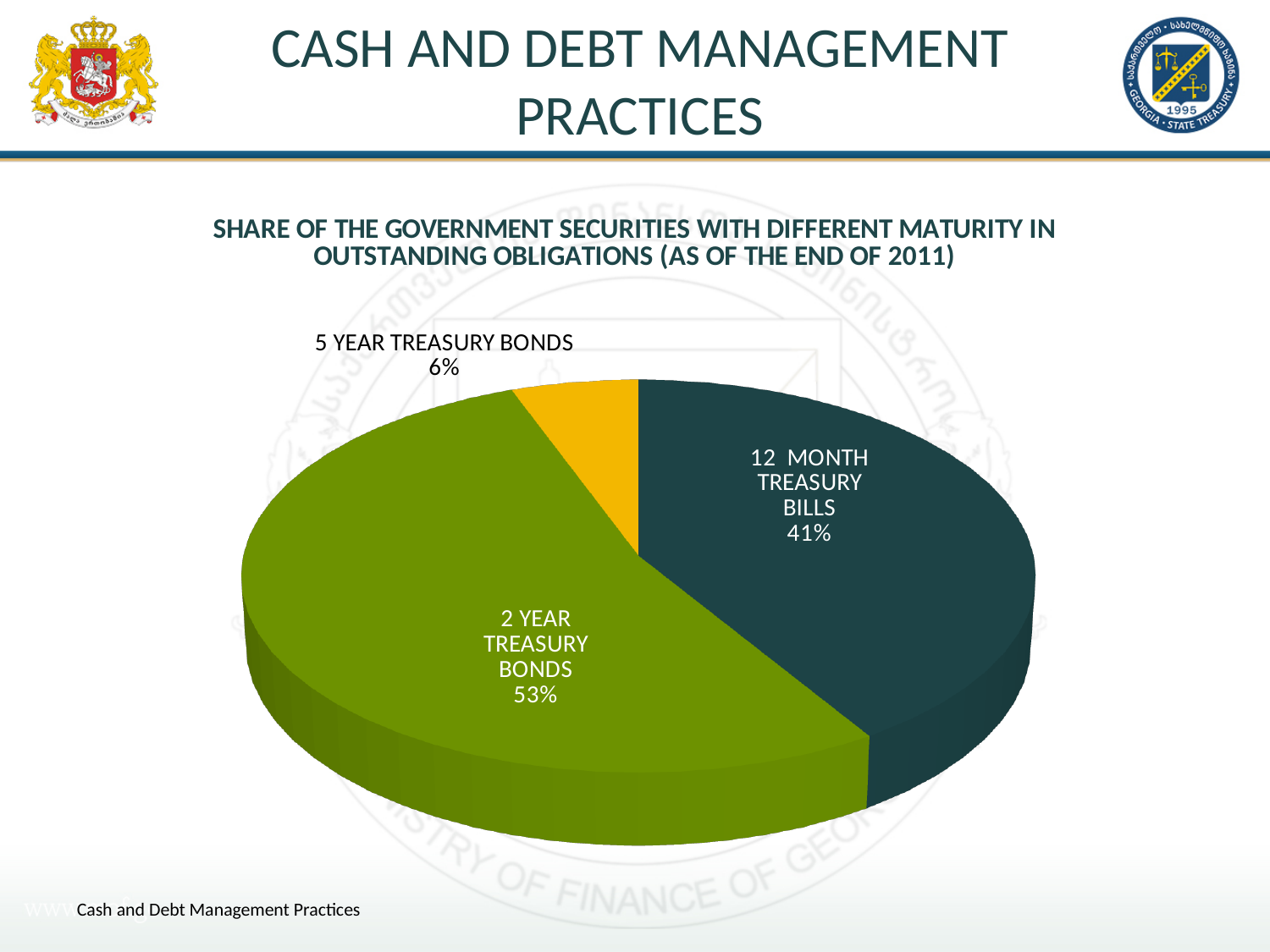
What kind of chart is shown on the slide? Pie chart Which has a larger share: 12 month treasury bills or 5 year treasury bonds? 12 month treasury bills What is the difference in share between 12 month treasury bills and 5 year treasury bonds? 35% What is the title of the chart? Share of the government securities with different maturity in outstanding obligations (as of the end of 2011) What share of outstanding obligations is held by 5 year treasury bonds? 6% Which security type has the smallest share of outstanding obligations? 5 year treasury bonds Which security type has the largest share of outstanding obligations? 2 year treasury bonds What share of outstanding obligations is held by 2 year treasury bonds? 53% What share of outstanding obligations is held by 12 month treasury bills? 41% What colour is the slice for 5 year treasury bonds? Yellow What is the difference in share between 2 year treasury bonds and 12 month treasury bills? 12% How many slices does the pie chart have? 3